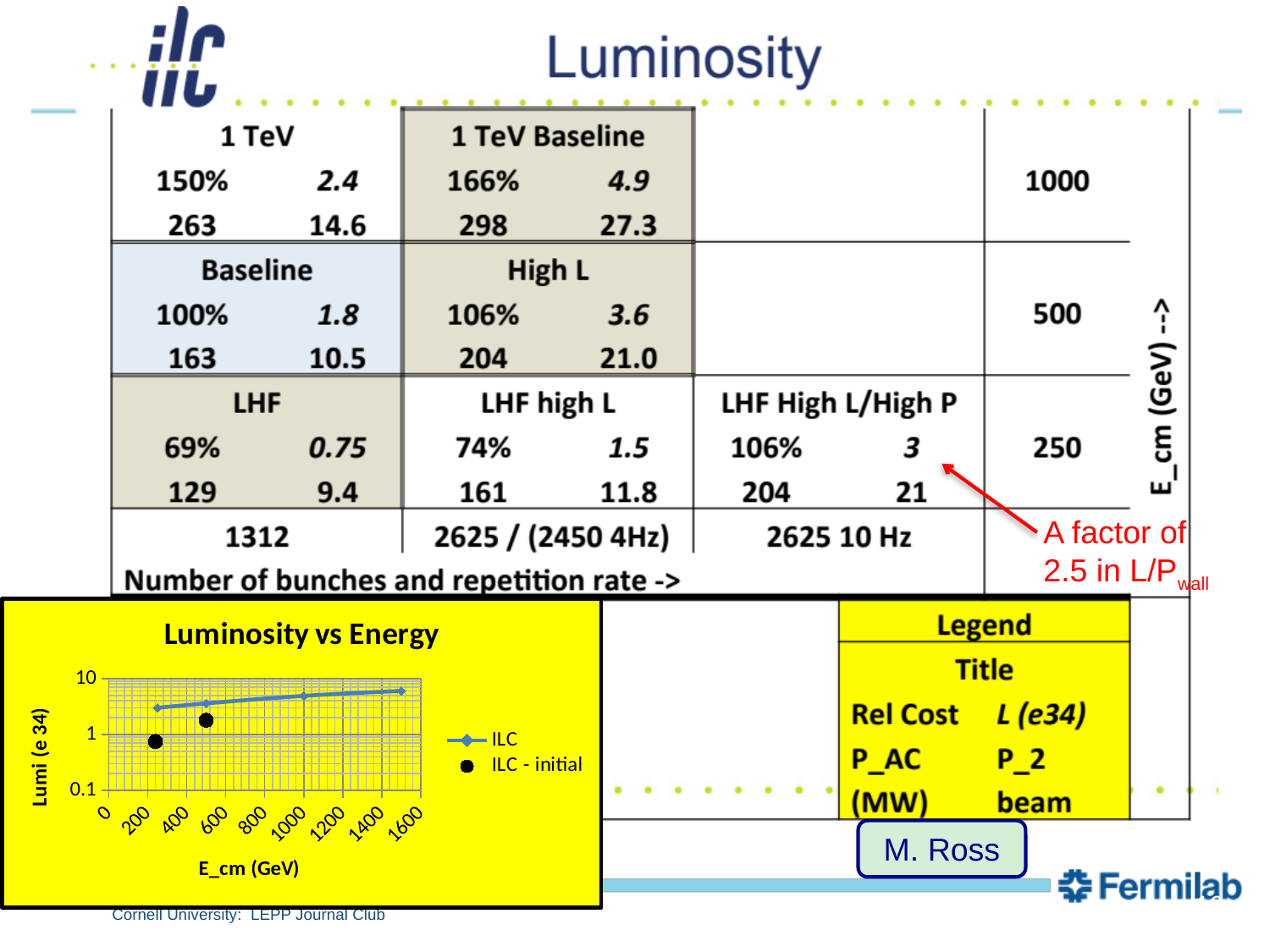
What are the two series named in the legend of the "Luminosity vs Energy" chart? ILC and ILC - initial How many series does the legend of the "Luminosity vs Energy" chart list? 2 In the "Luminosity vs Energy" chart, which ILC point has the highest luminosity, the one at about 250 GeV or the one at about 1500 GeV? about 1500 GeV What kind of chart is the "Luminosity vs Energy" chart? line chart In the "Luminosity vs Energy" chart, is the ILC - initial value at about 500 GeV greater or less than 1? greater In the "Luminosity vs Energy" chart, is the ILC value at about 1500 GeV greater or less than 10? less What is the label of the y axis of the "Luminosity vs Energy" chart? Lumi (e 34) In the "Luminosity vs Energy" chart, is the ILC - initial value at about 250 GeV greater or less than 1? less In the "Luminosity vs Energy" chart, at about 500 GeV, which series has the higher luminosity, ILC or ILC - initial? ILC How many data points does the ILC - initial series have in the "Luminosity vs Energy" chart? 2 In the "Luminosity vs Energy" chart, does the ILC series rise or fall as E_cm increases? rise